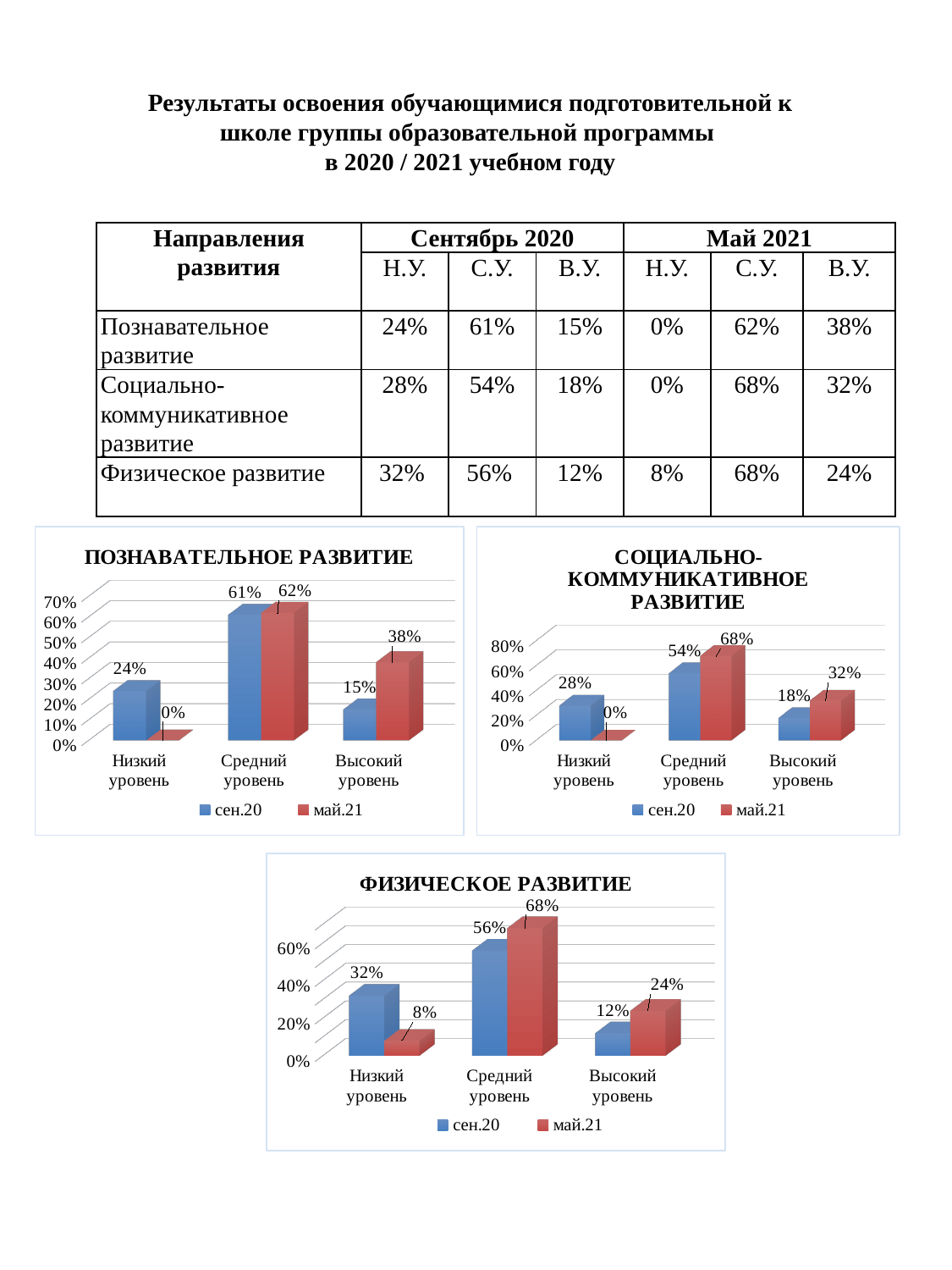
How many series does the legend of the 'ФИЗИЧЕСКОЕ РАЗВИТИЕ' chart list? 2 In the 'СОЦИАЛЬНО-КОММУНИКАТИВНОЕ РАЗВИТИЕ' chart, what is the value for 'Средний уровень' in the 'май.21' series? 68% In the 'ПОЗНАВАТЕЛЬНОЕ РАЗВИТИЕ' chart, which category has the highest value in the 'сен.20' series? Средний уровень In the 'ПОЗНАВАТЕЛЬНОЕ РАЗВИТИЕ' chart, what is the value for 'Высокий уровень' in the 'май.21' series? 38% What type of chart is the 'ПОЗНАВАТЕЛЬНОЕ РАЗВИТИЕ' chart? Bar chart In the 'ПОЗНАВАТЕЛЬНОЕ РАЗВИТИЕ' chart, what is the difference between the 'май.21' and 'сен.20' values for 'Высокий уровень'? 23% In the 'ФИЗИЧЕСКОЕ РАЗВИТИЕ' chart, how many categories are shown on the x axis? 3 In the 'СОЦИАЛЬНО-КОММУНИКАТИВНОЕ РАЗВИТИЕ' chart, which is larger for 'Высокий уровень': 'сен.20' or 'май.21'? май.21 In the 'ФИЗИЧЕСКОЕ РАЗВИТИЕ' chart, what is the value for 'Низкий уровень' in the 'май.21' series? 8% In the 'ПОЗНАВАТЕЛЬНОЕ РАЗВИТИЕ' chart, what is the value for 'Низкий уровень' in the 'сен.20' series? 24% In the 'СОЦИАЛЬНО-КОММУНИКАТИВНОЕ РАЗВИТИЕ' chart, which category has the lowest value in the 'май.21' series? Низкий уровень In the 'ФИЗИЧЕСКОЕ РАЗВИТИЕ' chart, what is the difference between the 'сен.20' and 'май.21' values for 'Низкий уровень'? 24%